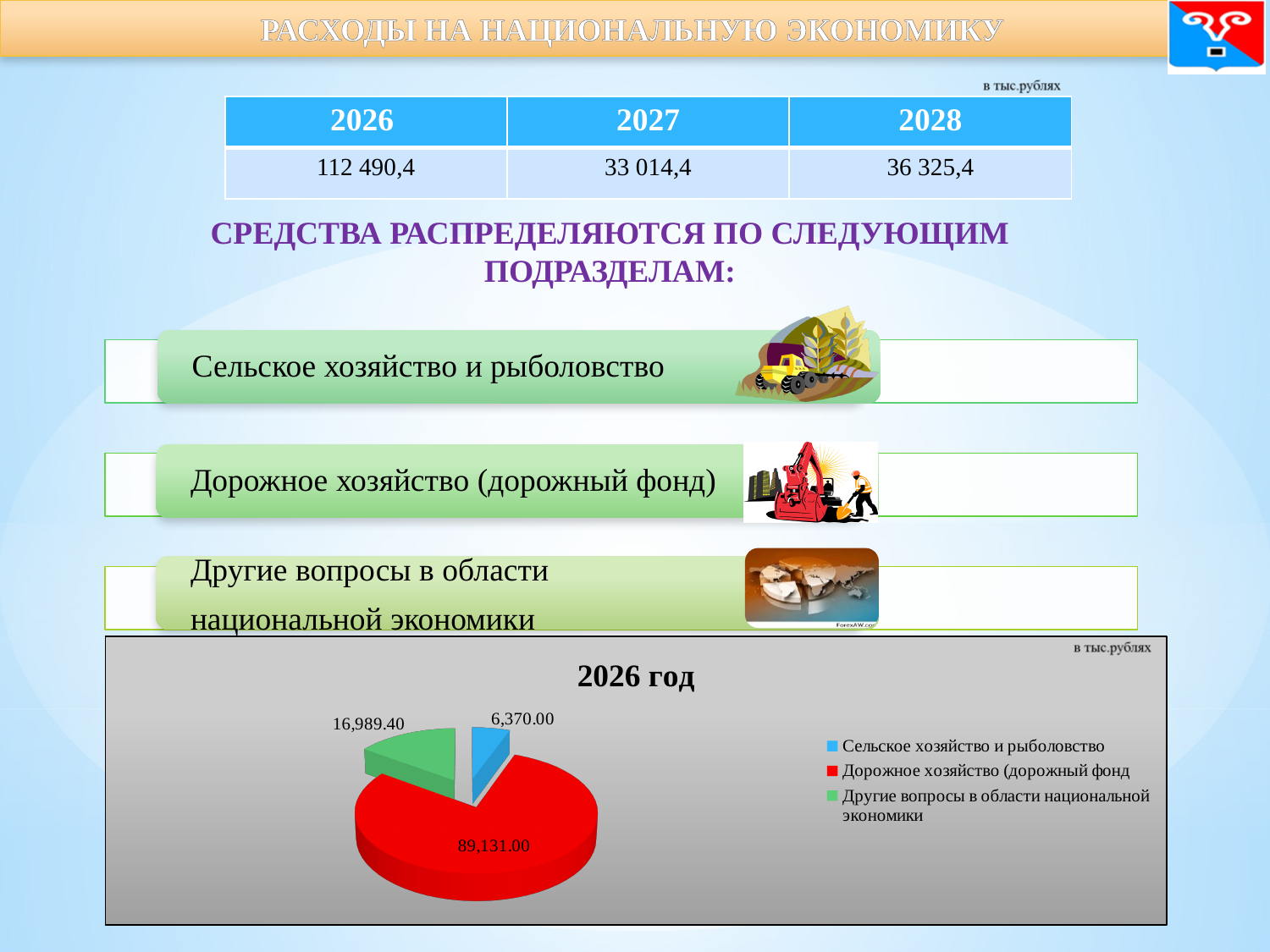
What type of chart is shown on the slide? pie chart What is the value for Другие вопросы в области национальной экономики in the pie chart? 16,989.40 How many slices does the pie chart have? 3 Which category has the smallest slice in the pie chart? Сельское хозяйство и рыболовство What colour is the slice for Дорожное хозяйство (дорожный фонд) in the pie chart? red What is the difference between the values for Дорожное хозяйство (дорожный фонд) and Другие вопросы в области национальной экономики in the pie chart? 72,141.60 What is the title of the pie chart? 2026 год Which is larger in the pie chart: Другие вопросы в области национальной экономики or Сельское хозяйство и рыболовство? Другие вопросы в области национальной экономики What is the value for Сельское хозяйство и рыболовство in the pie chart? 6,370.00 How many entries does the legend of the pie chart list? 3 What is the value for Дорожное хозяйство (дорожный фонд) in the pie chart? 89,131.00 Which category has the largest slice in the pie chart? Дорожное хозяйство (дорожный фонд)